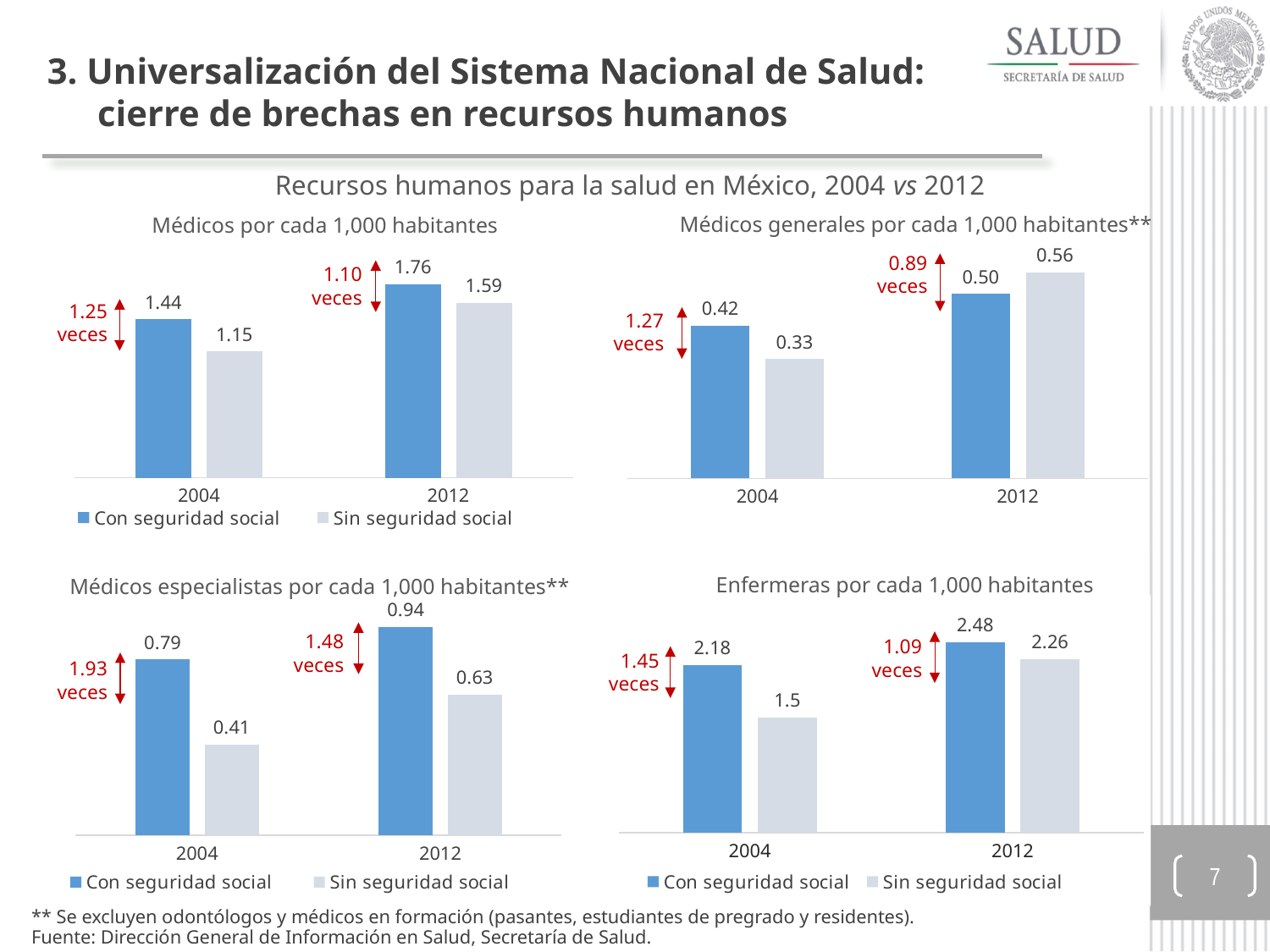
In the 'Enfermeras por cada 1,000 habitantes' chart, what is the value for 'Sin seguridad social' in 2004? 1.5 In the 'Médicos por cada 1,000 habitantes' chart, what is the difference between 'Con seguridad social' and 'Sin seguridad social' in 2012? 0.17 What type of chart is the 'Enfermeras por cada 1,000 habitantes' chart? bar chart In the 'Médicos especialistas por cada 1,000 habitantes**' chart, what is the value for 'Sin seguridad social' in 2004? 0.41 In the 'Médicos generales por cada 1,000 habitantes**' chart, which is larger in 2012: 'Con seguridad social' or 'Sin seguridad social'? Sin seguridad social In the 'Médicos generales por cada 1,000 habitantes**' chart, what is the value for 'Sin seguridad social' in 2012? 0.56 How many series does the legend of the 'Médicos por cada 1,000 habitantes' chart list? 2 In the 'Enfermeras por cada 1,000 habitantes' chart, does the 'Con seguridad social' value rise or fall from 2004 to 2012? rise In the 'Médicos por cada 1,000 habitantes' chart, what is the value for 'Con seguridad social' in 2004? 1.44 In the 'Médicos especialistas por cada 1,000 habitantes**' chart, which bar is the highest? Con seguridad social, 2012 (0.94) In the 'Enfermeras por cada 1,000 habitantes' chart, what is the difference between 'Con seguridad social' and 'Sin seguridad social' in 2012? 0.22 In the 'Médicos especialistas por cada 1,000 habitantes**' chart, what is the difference between 'Con seguridad social' and 'Sin seguridad social' in 2012? 0.31